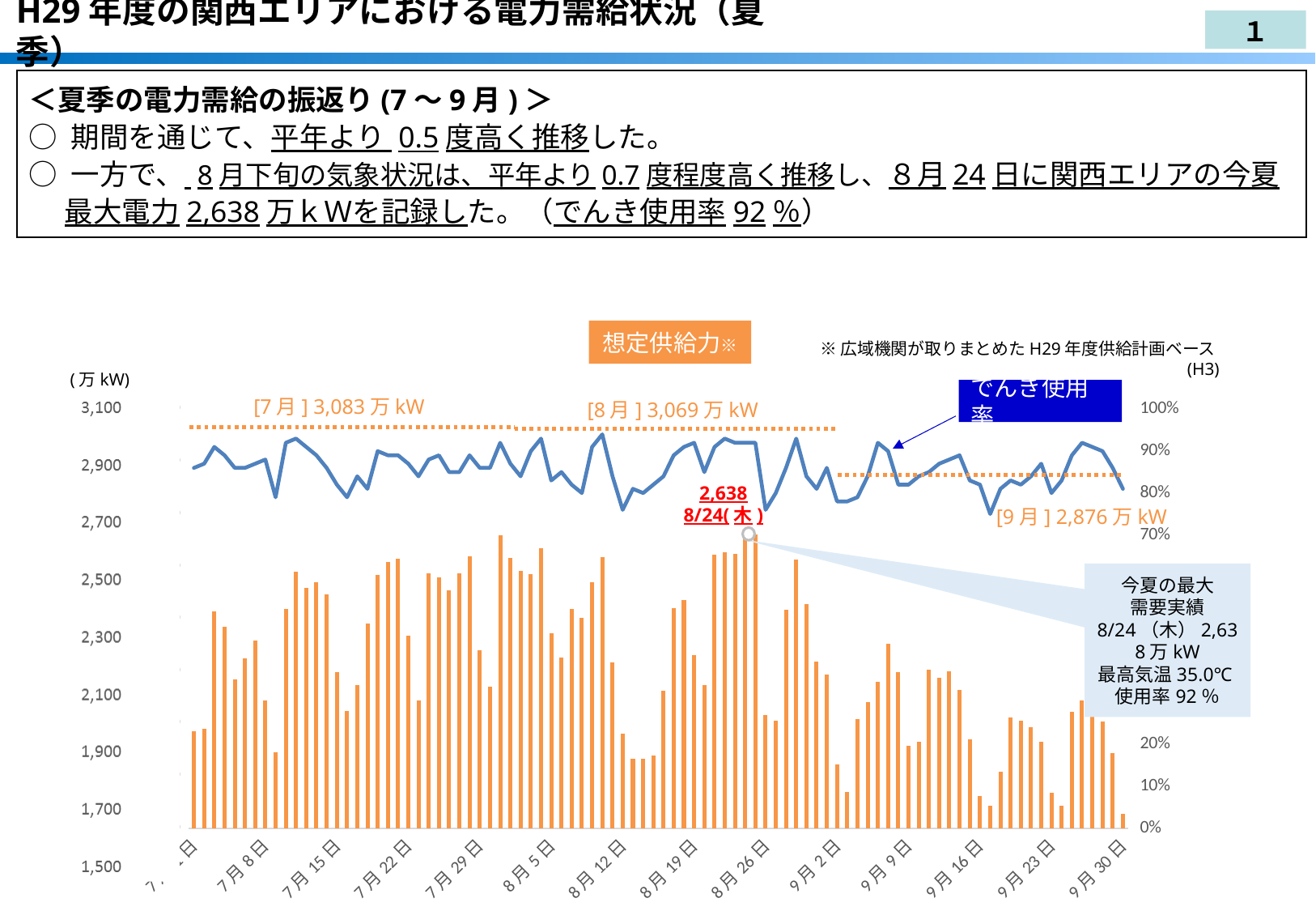
What kind of chart is used to show the daily demand and the usage rate? Combined bar and line chart What is the assumed supply capacity (想定供給力) shown for July (7月)? 3,083万kW Which month has the highest assumed supply capacity (想定供給力) on the chart? 7月 What is the difference between the assumed supply capacity for August and for September, in 万kW? 193 What is the assumed supply capacity (想定供給力) shown for September (9月)? 2,876万kW Is the assumed supply capacity for July larger or smaller than that for August? larger What is the assumed supply capacity (想定供給力) shown for August (8月)? 3,069万kW What was the maximum demand (今夏の最大需要実績) recorded in the chart, in 万kW? 2,638 On which date did the peak demand of 2,638 万kW occur? 8/24(木) Is the peak demand bar on 8/24 greater or less than 2,500 万kW? greater What was the electricity usage rate (でんき使用率) on the peak demand day, 8/24? 92% Which month has the lowest assumed supply capacity (想定供給力) on the chart? 9月